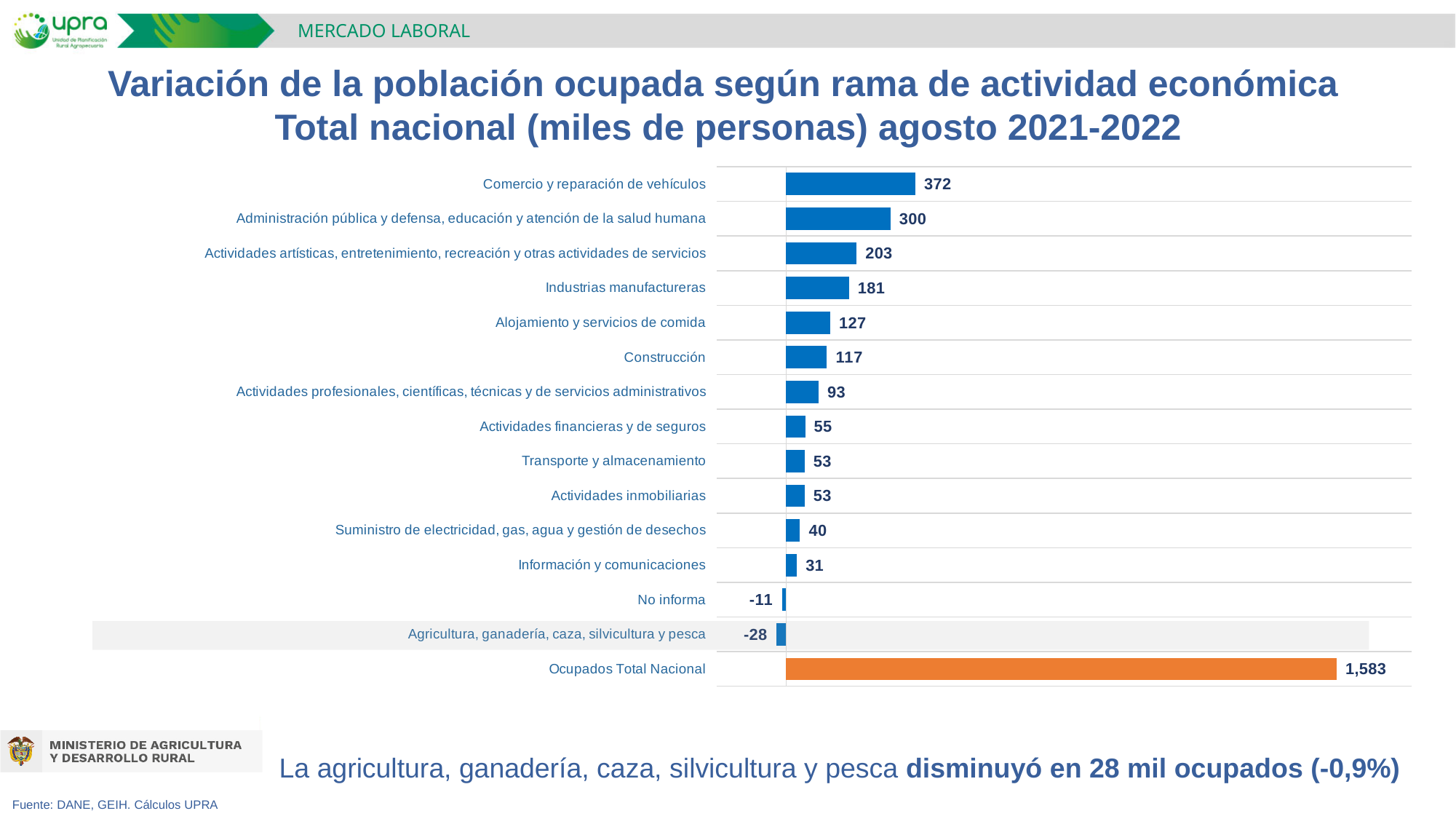
What is the value for Agricultura, ganadería, caza, silvicultura y pesca? -28 How many categories are shown in the chart? 15 Which is larger, the value for Industrias manufactureras or the value for Alojamiento y servicios de comida? Industrias manufactureras How many categories have a negative value? 2 What is the value for Construcción? 117 Which category has the lowest value? Agricultura, ganadería, caza, silvicultura y pesca What kind of chart is shown on the slide? Bar chart Excluding Ocupados Total Nacional, which category has the highest value? Comercio y reparación de vehículos What is the difference between the values for Comercio y reparación de vehículos and Administración pública y defensa, educación y atención de la salud humana? 72 Which bar is shown in orange rather than blue? Ocupados Total Nacional What is the value for Ocupados Total Nacional? 1,583 What is the value for Comercio y reparación de vehículos? 372